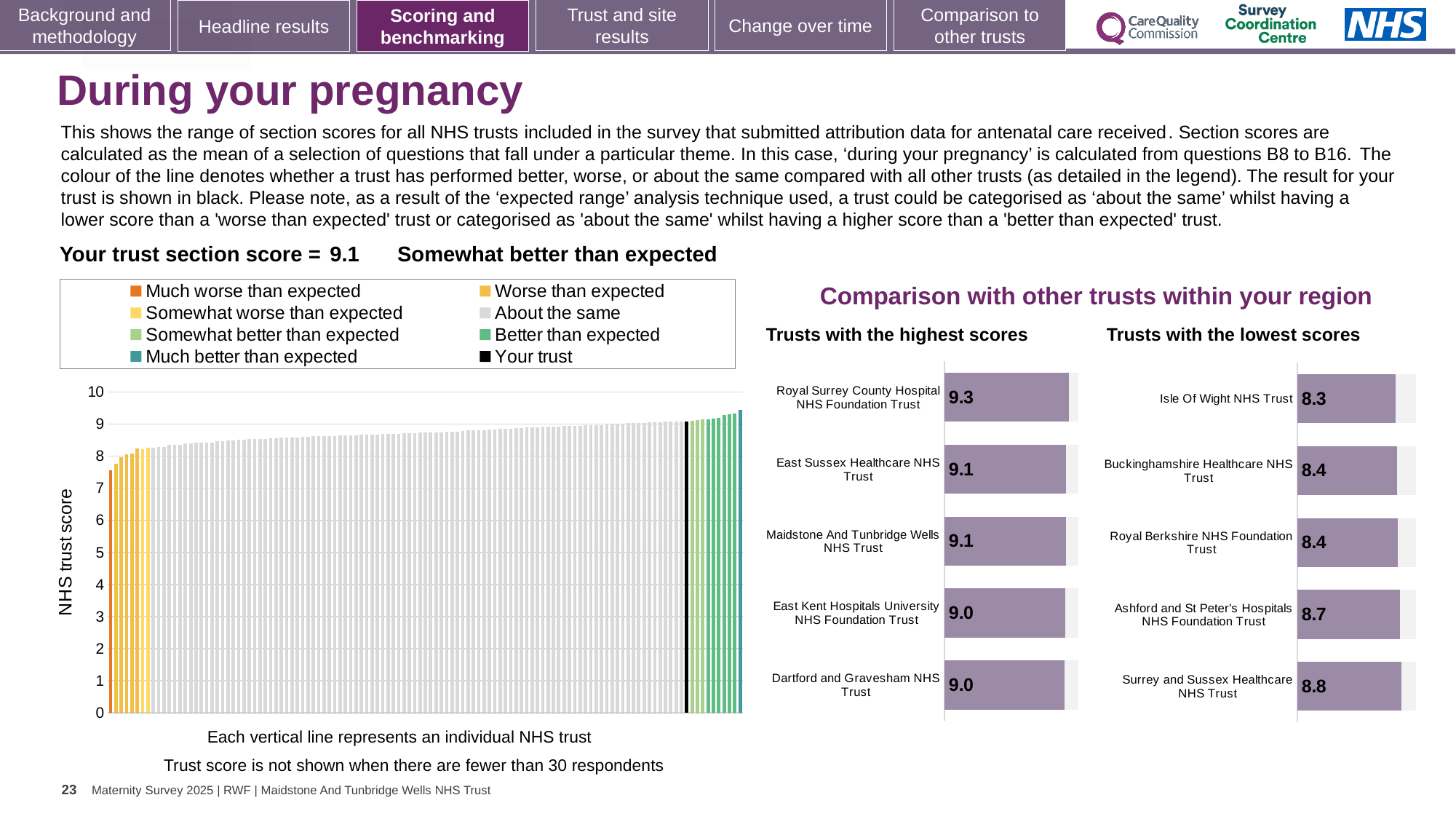
In the 'Trusts with the lowest scores' chart, what is the score for Isle Of Wight NHS Trust? 8.3 In the 'Trusts with the lowest scores' chart, what is the score for Ashford and St Peter's Hospitals NHS Foundation Trust? 8.7 How many trusts are shown in the 'Trusts with the highest scores' chart? 5 How many entries does the legend of the NHS trust score chart list? 8 In the 'Trusts with the highest scores' chart, which has the larger score: Royal Surrey County Hospital NHS Foundation Trust or Dartford and Gravesham NHS Trust? Royal Surrey County Hospital NHS Foundation Trust In the 'Trusts with the lowest scores' chart, what is the difference between the scores of Surrey and Sussex Healthcare NHS Trust and Isle Of Wight NHS Trust? 0.5 In the 'Trusts with the highest scores' chart, which trust has the highest score? Royal Surrey County Hospital NHS Foundation Trust In the 'Trusts with the highest scores' chart, what is the score for Royal Surrey County Hospital NHS Foundation Trust? 9.3 In the 'Trusts with the lowest scores' chart, which trust has the lowest score? Isle Of Wight NHS Trust In the NHS trust score chart on the left, do the values rise or fall from left to right along the x axis? Rise In the NHS trust score chart on the left, is the value of the leftmost (lowest) bar greater or less than 8? less What kind of chart is the NHS trust score chart on the left? Bar chart